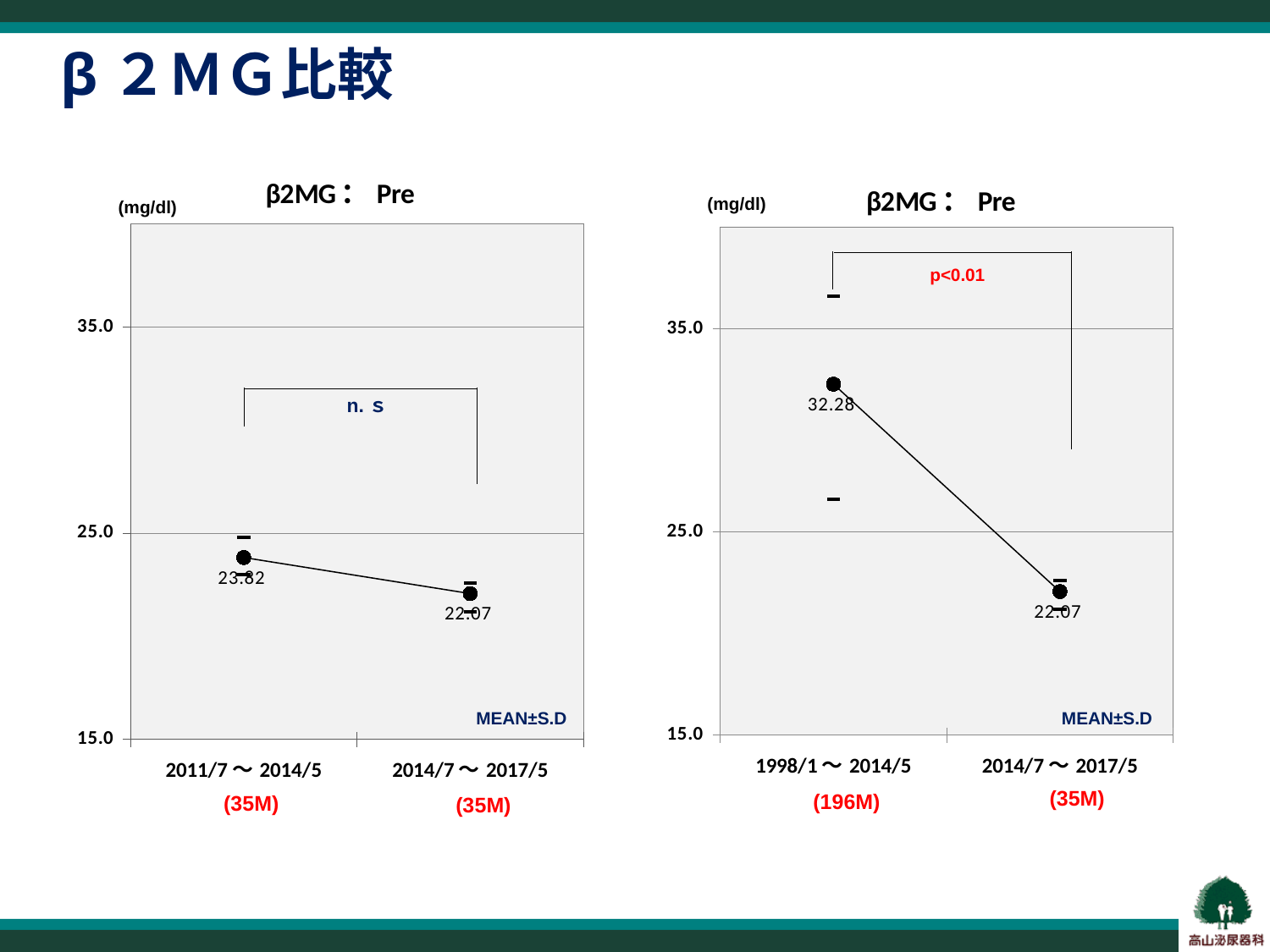
What p-value is shown in the right chart? p<0.01 In the left chart, which period has the lower value? 2014/7～2017/5 In the right chart, is the value for 1998/1～2014/5 greater or less than 25.0? greater In the right chart, what is the value for 2014/7～2017/5? 22.07 How many periods are plotted in the right chart? 2 In the right chart, what is the value for 1998/1～2014/5? 32.28 In the right chart, which period has the higher value? 1998/1～2014/5 In the right chart, what is the difference between the values for 1998/1～2014/5 and 2014/7～2017/5? 10.21 In the left chart, do the values rise or fall from the first period to the second? fall In the left chart, what is the difference between the values for 2011/7～2014/5 and 2014/7～2017/5? 1.75 In the left chart, what is the value for 2014/7～2017/5? 22.07 In the left chart, what is the value for 2011/7～2014/5? 23.82